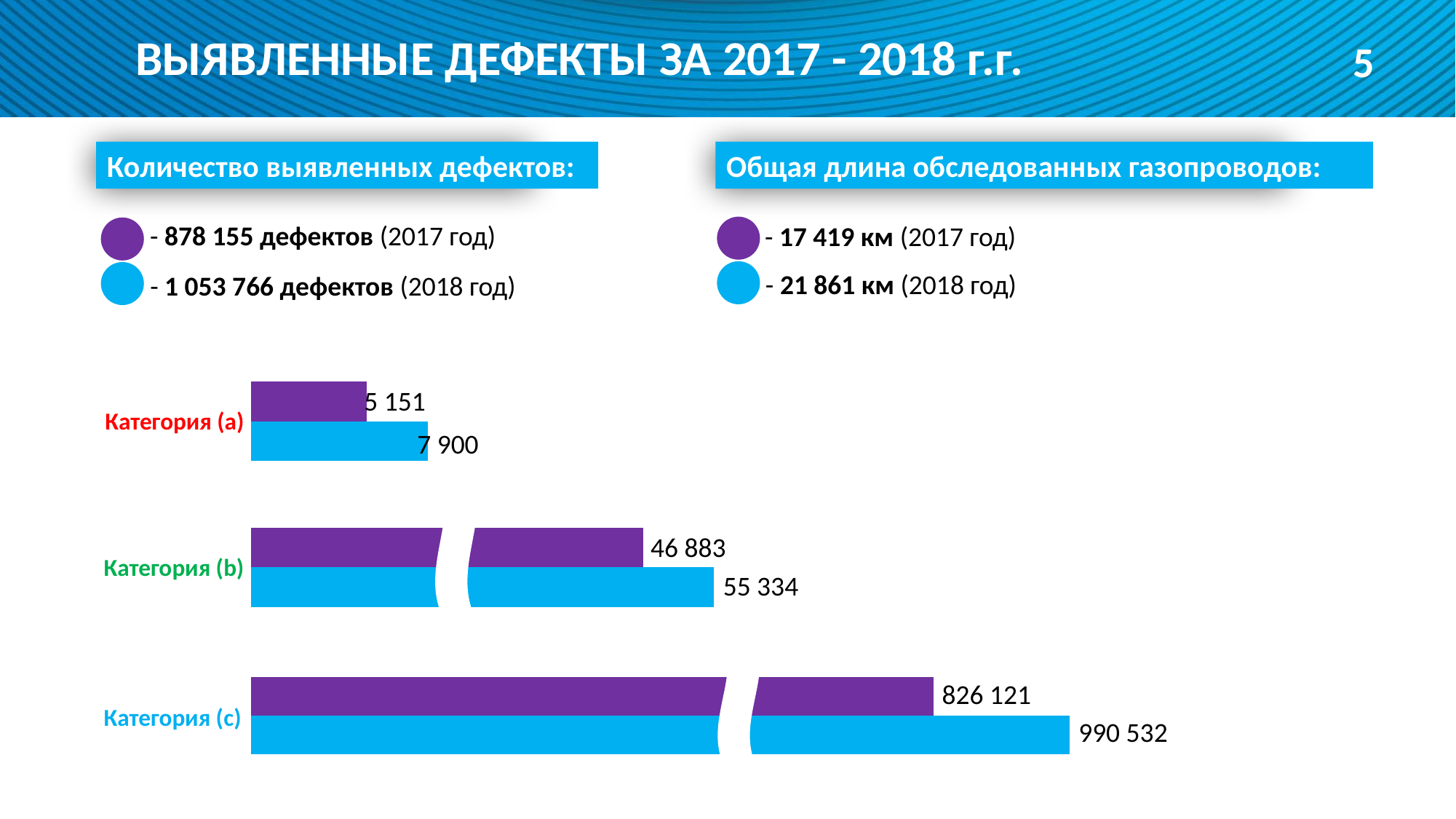
Which is larger for Категория (b): the 2017 value or the 2018 value? 2018 value Which category has the lowest 2017 value? Категория (a) What is the 2018 value for Категория (b)? 55 334 What type of chart is shown on the slide? Bar chart How many categories are shown in the chart? 3 Which category has the highest 2018 value? Категория (c) Which colour represents the 2018 values in the chart? Blue What is the difference between the 2018 and 2017 values for Категория (a)? 2 749 What is the 2018 value for Категория (c)? 990 532 What is the 2017 value for Категория (c)? 826 121 What is the 2017 value for Категория (a)? 5 151 What is the difference between the 2018 and 2017 values for Категория (c)? 164 411